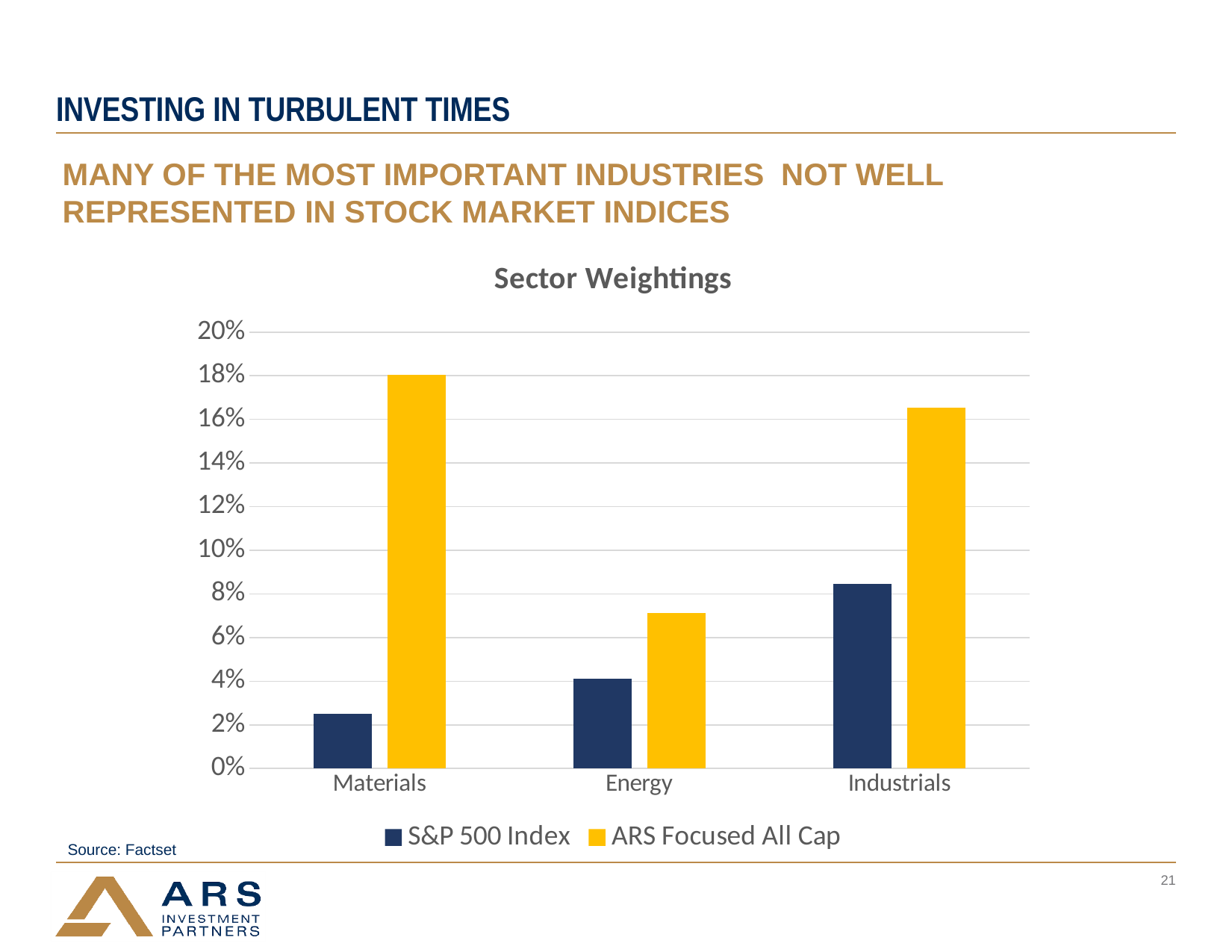
Is the S&P 500 Index weighting for Industrials greater or less than 6%? greater What is the title of the chart? Sector Weightings How many sector categories are shown on the x axis? 3 Which sector has the highest ARS Focused All Cap weighting? Materials How many series does the legend list? 2 Which series is shown in yellow in the legend? ARS Focused All Cap For Energy, which is larger: the S&P 500 Index weighting or the ARS Focused All Cap weighting? ARS Focused All Cap Which sector has the highest S&P 500 Index weighting? Industrials Is the ARS Focused All Cap weighting for Industrials greater or less than 14%? greater Is the S&P 500 Index weighting for Energy greater or less than 6%? less What type of chart is shown on the slide? bar chart Which sector has the lowest S&P 500 Index weighting? Materials